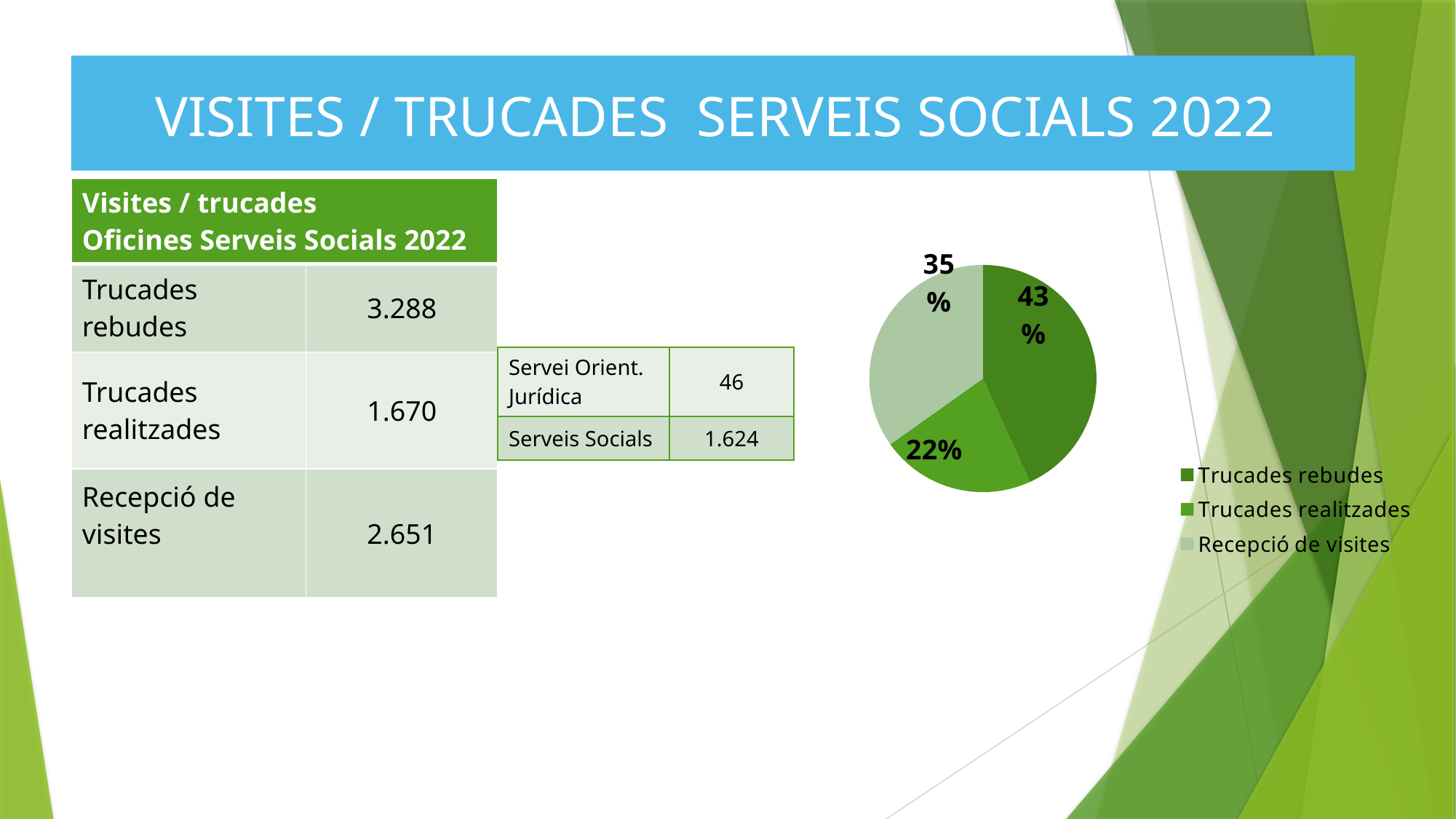
Which category has the largest slice in the pie chart? Trucades rebudes What kind of chart is shown on the slide? pie chart How many slices does the pie chart have? 3 What percentage does the pie chart show for Recepció de visites? 35% By how many percentage points does the Trucades rebudes slice exceed the Trucades realitzades slice? 21 What percentage does the pie chart show for Trucades rebudes? 43% What percentage does the pie chart show for Trucades realitzades? 22% By how many percentage points does the Trucades rebudes slice exceed the Recepció de visites slice? 8 Which category has the smallest slice in the pie chart? Trucades realitzades In the pie chart, which is larger: Recepció de visites or Trucades realitzades? Recepció de visites Which legend entry is shown in the lightest green in the pie chart? Recepció de visites How many entries does the pie chart's legend list? 3